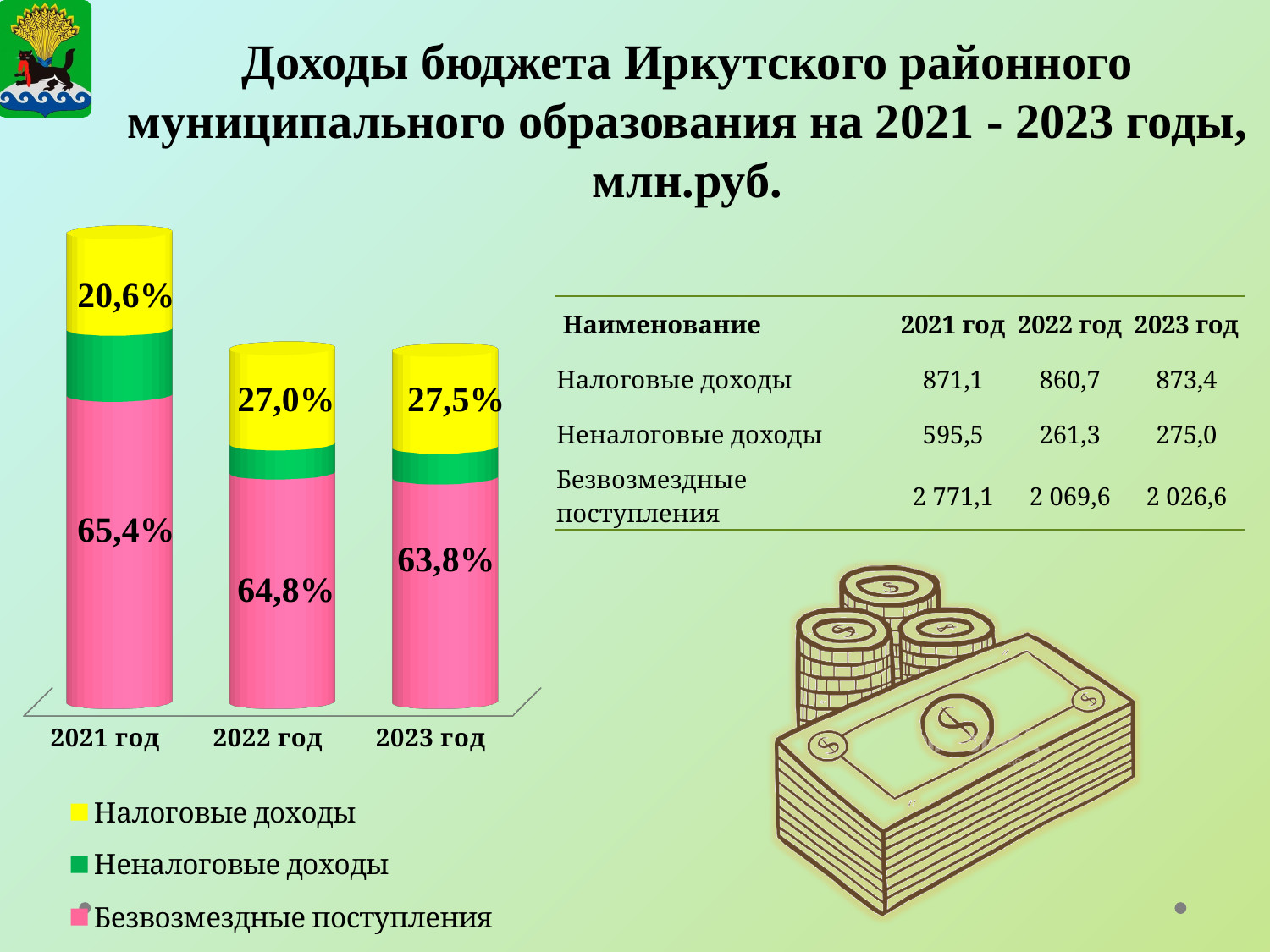
What share does Безвозмездные поступления have in the 2023 год bar? 63,8% How many series does the chart legend list? 3 What is the difference between the Налоговые доходы share in 2023 год and in 2021 год? 6,9% Which colour represents Неналоговые доходы in the chart? Green What share does Безвозмездные поступления have in the 2022 год bar? 64,8% Which is larger: the Безвозмездные поступления share in 2021 год or in 2022 год? 2021 год In which year is the share of Безвозмездные поступления the lowest? 2023 год How many years (bars) are shown in the chart? 3 In which year is the share of Налоговые доходы the highest? 2023 год What share does Налоговые доходы have in the 2022 год bar? 27,0% What type of chart is shown on the slide? Stacked bar chart What share does Налоговые доходы have in the 2021 год bar? 20,6%